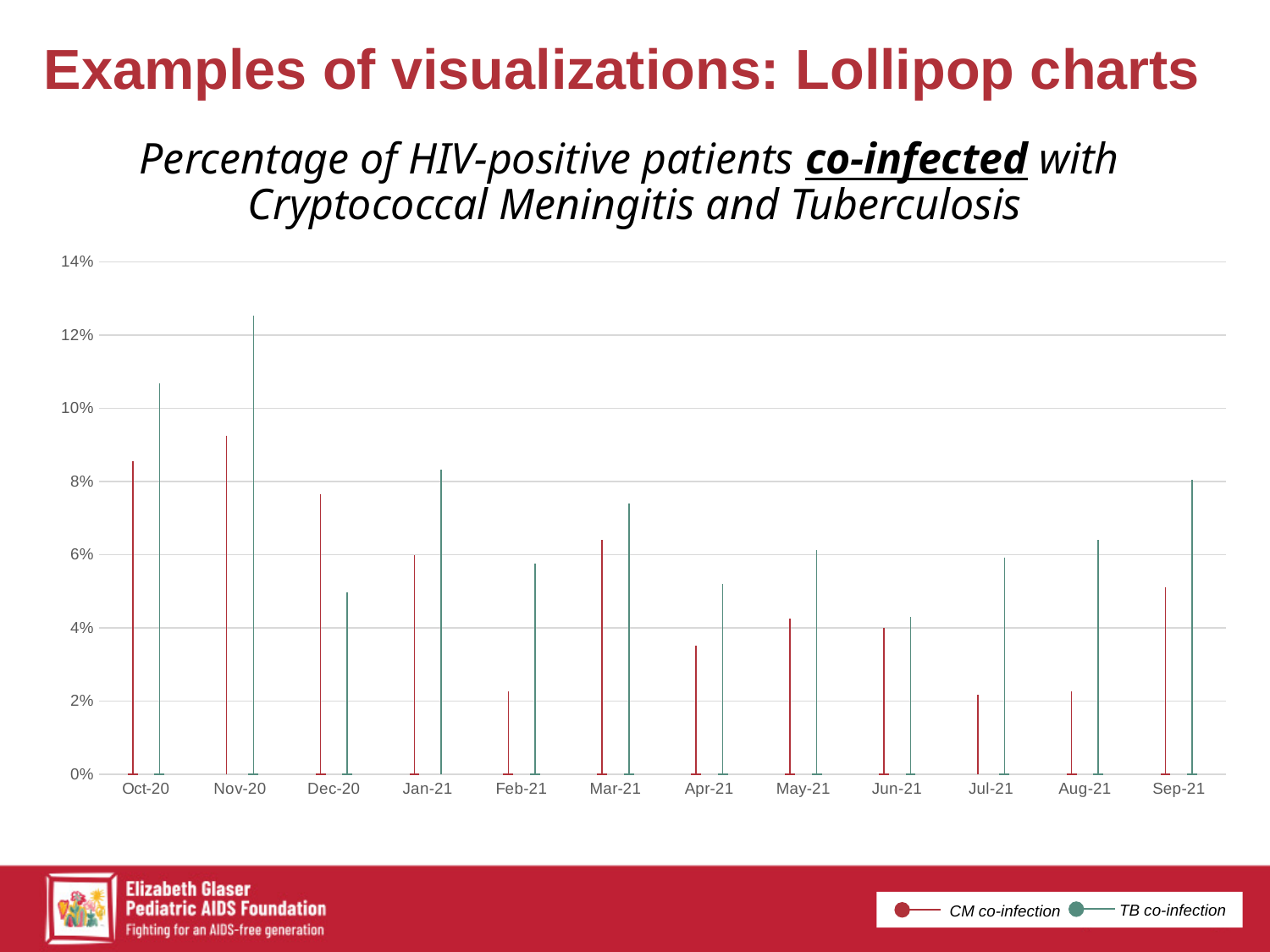
Is the TB co-infection value for Oct-20 greater or less than 10%? greater In Dec-20, which is larger: CM co-infection or TB co-infection? CM co-infection Is the CM co-infection value for Feb-21 greater or less than 4%? less Which month has the highest CM co-infection value? Nov-20 How many series does the legend list? 2 Is the CM co-infection value for Dec-20 greater or less than 6%? greater Which series is shown in red in the legend? CM co-infection In Oct-20, which is larger: CM co-infection or TB co-infection? TB co-infection What kind of chart is shown on the slide? Lollipop chart Which month has the highest TB co-infection value? Nov-20 How many months are shown on the x axis? 12